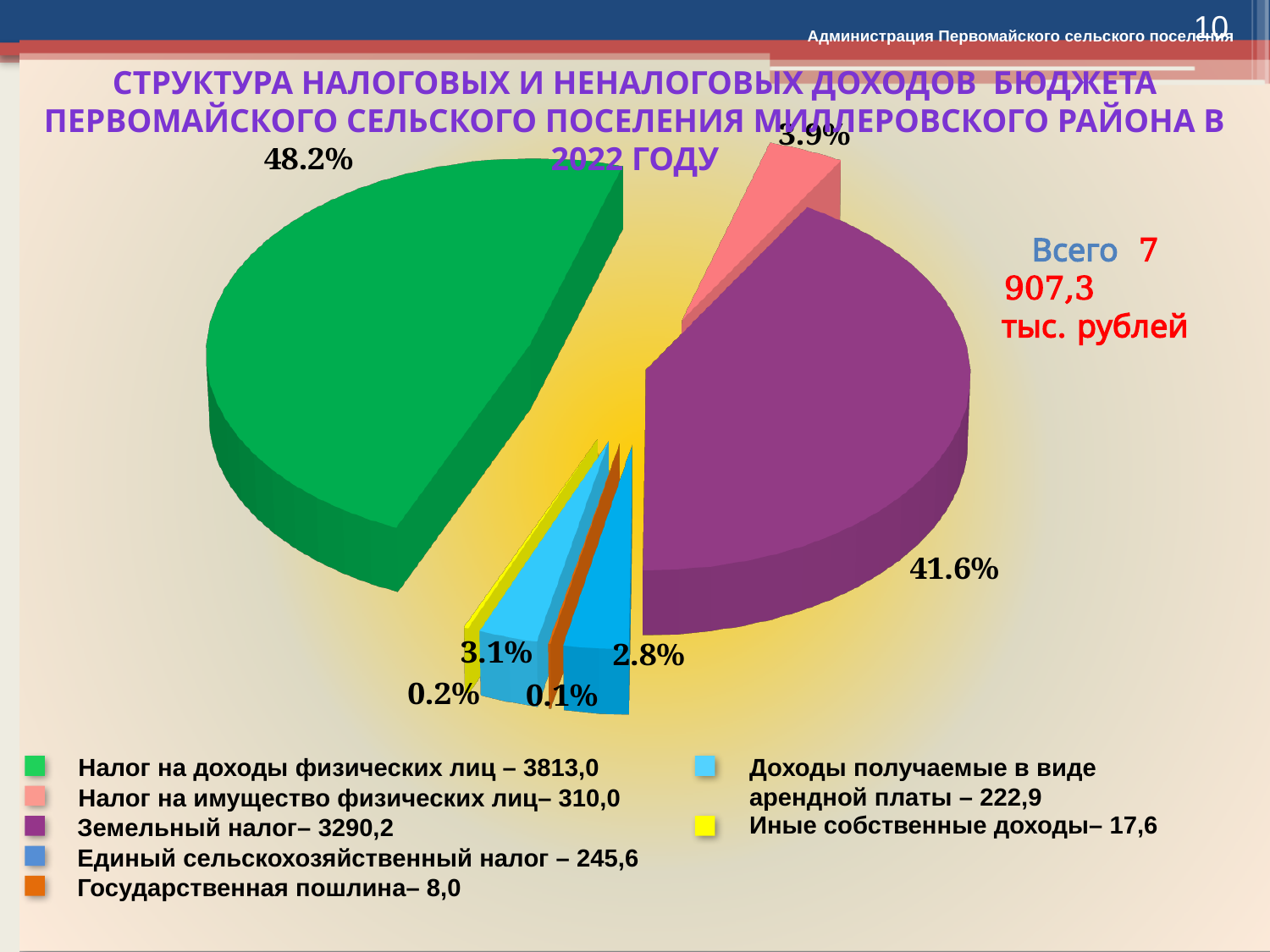
How many categories does the legend of the pie chart list? 7 Which category has the largest slice of the pie? Налог на доходы физических лиц What share of the pie does Земельный налог have? 41.6% Which category has the smallest slice of the pie? Государственная пошлина What is the value shown in the legend for Земельный налог? 3290,2 What share of the pie does Налог на имущество физических лиц have? 3.9% What total amount is stated next to the pie chart? 7 907,3 тыс. рублей Which is larger: the share for Налог на доходы физических лиц or the share for Земельный налог? Налог на доходы физических лиц What is the value shown in the legend for Доходы получаемые в виде арендной платы? 222,9 What kind of chart is shown on the slide? pie chart What is the difference in percentage points between the shares of Налог на доходы физических лиц and Земельный налог? 6.6 What share of the pie does Налог на доходы физических лиц have? 48.2%